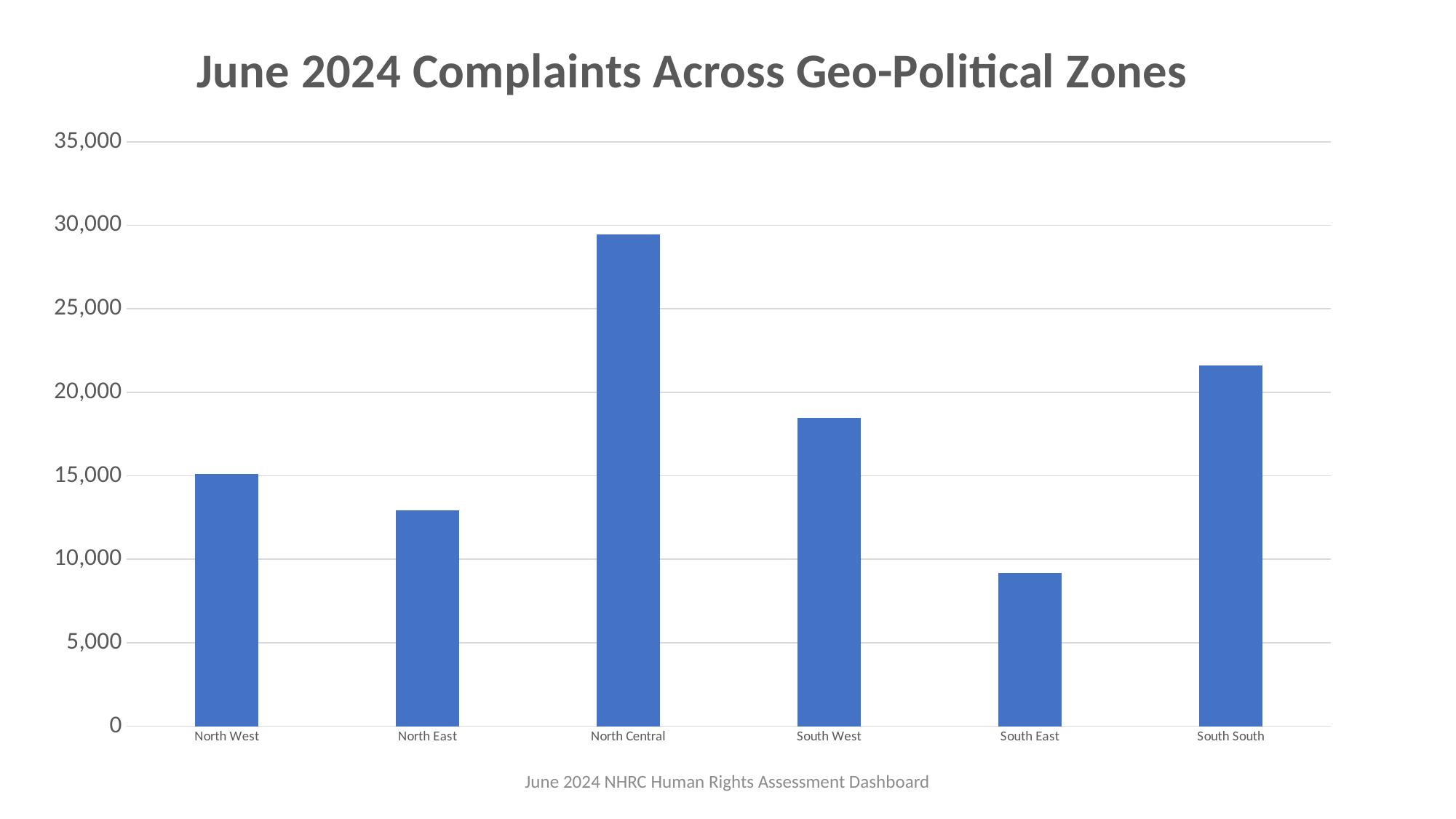
How many geo-political zones are shown on the x axis? 6 Is the value for South South greater or less than 20,000? greater What type of chart is shown on the slide? bar chart Is the value for South East greater or less than 10,000? less What is the title of the chart? June 2024 Complaints Across Geo-Political Zones Is the value for North Central greater or less than 25,000? greater Which geo-political zone has the highest number of complaints? North Central Which geo-political zone has the lowest number of complaints? South East What is the caption text shown below the chart? June 2024 NHRC Human Rights Assessment Dashboard Which has more complaints, South West or North West? South West Which has more complaints, North East or South South? South South